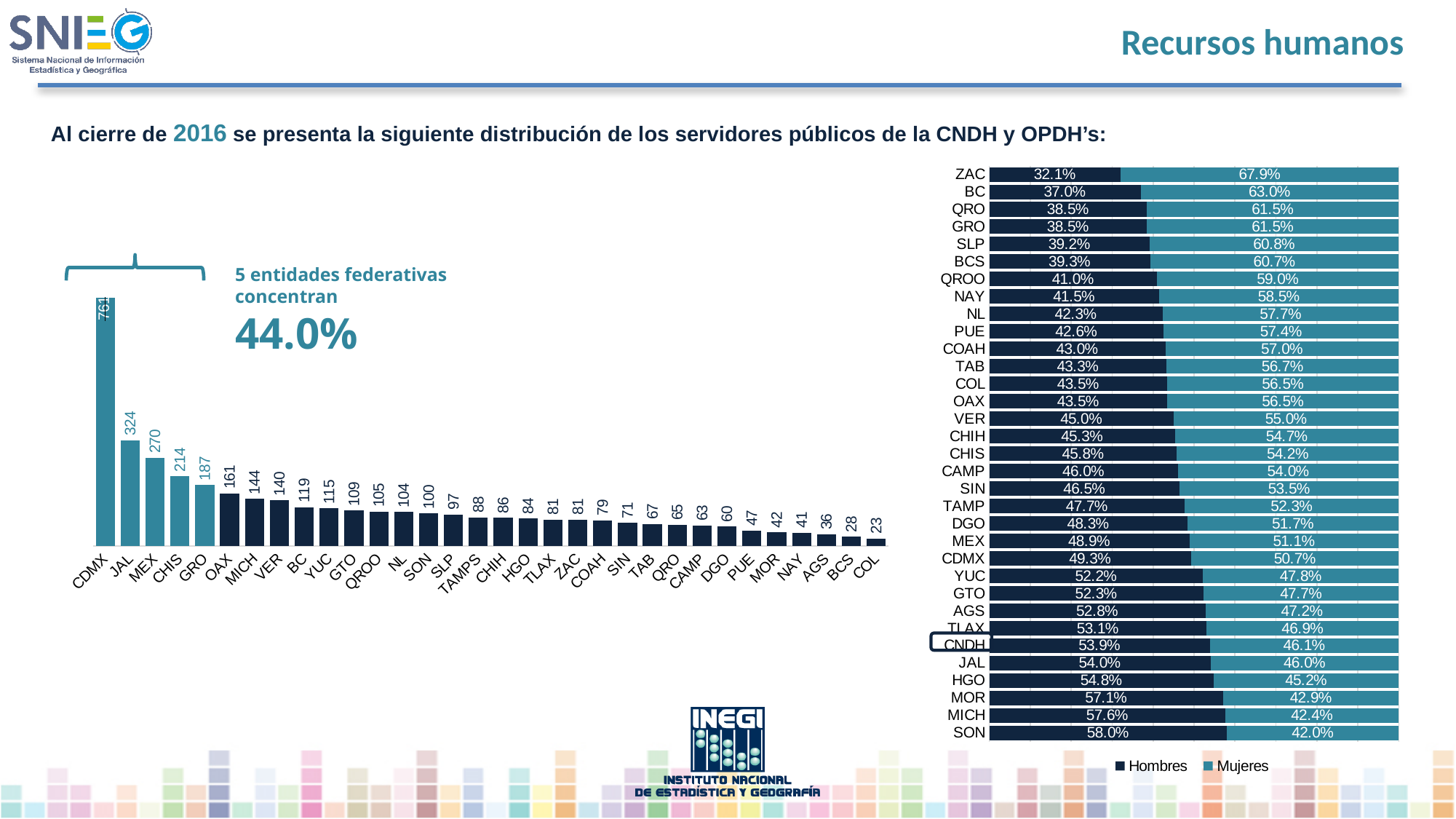
In the left bar chart, which category has the highest value? CDMX In the left bar chart, which is larger, the value for OAX or the value for MICH? OAX In the left bar chart, what is the value for JAL? 324 In the right stacked bar chart, how many series does the legend list? 2 In the left bar chart, what is the difference between the values for MEX and CHIS? 56 In the left bar chart, what is the value for COL? 23 In the left bar chart, which category has the lowest value? COL In the right stacked bar chart, what is the Mujeres percentage for SON? 42.0% In the left bar chart, how many categories are shown? 32 In the right stacked bar chart, what is the Hombres percentage for ZAC? 32.1% What kind of chart is the chart on the right of the slide? Stacked bar chart In the right stacked bar chart, which category has the highest Mujeres percentage? ZAC